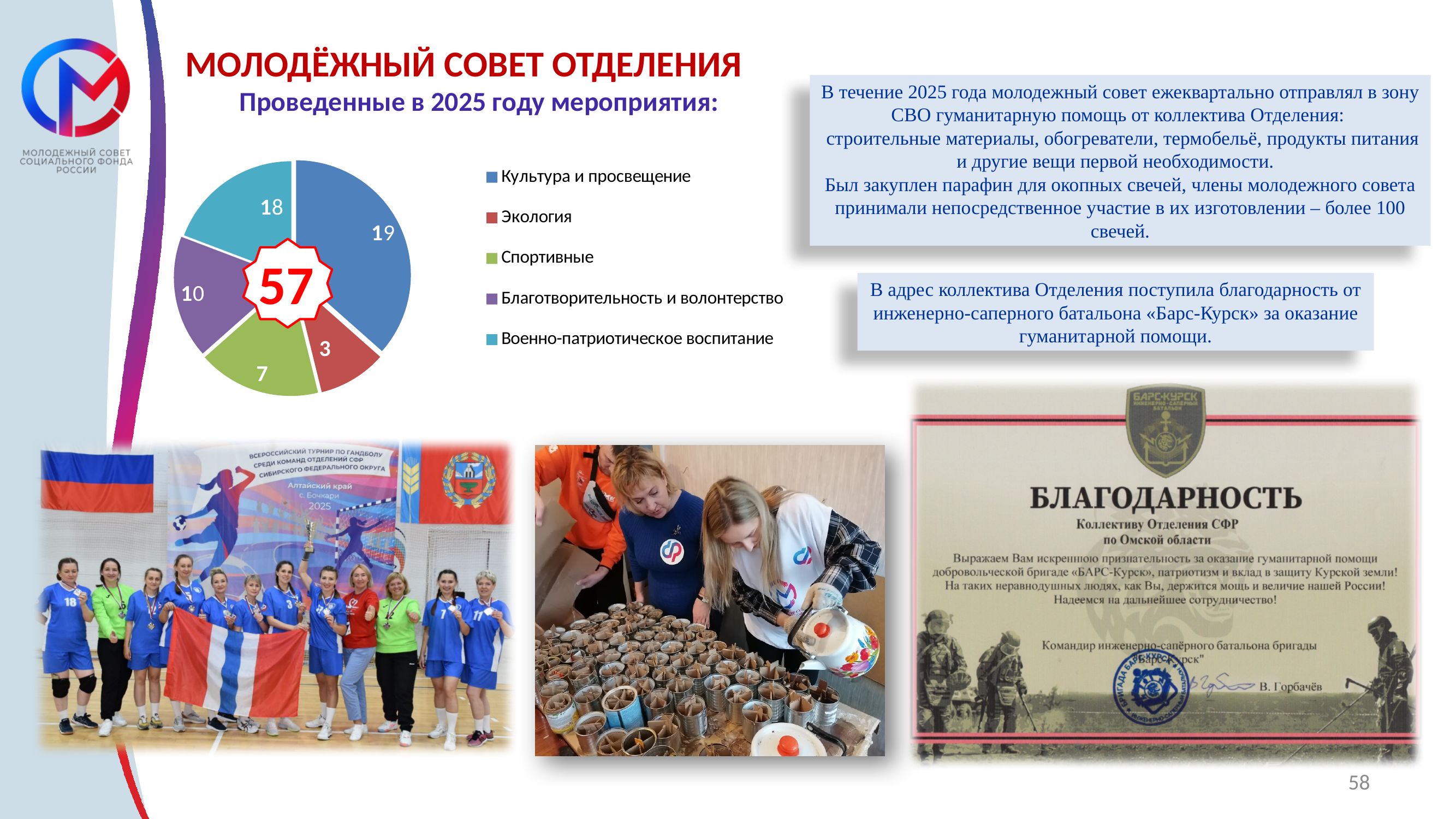
What is the value for Культура и просвещение in the pie chart? 19 What total number is shown in the centre of the pie chart? 57 Which category has the smallest slice in the pie chart? Экология Which is larger in the pie chart: Благотворительность и волонтерство or Спортивные? Благотворительность и волонтерство What is the value for Экология in the pie chart? 3 What is the value for Спортивные in the pie chart? 7 What is the value for Военно-патриотическое воспитание in the pie chart? 18 What is the difference between the values for Культура и просвещение and Военно-патриотическое воспитание? 1 What kind of chart is shown on the slide? pie chart Which category has the largest slice in the pie chart? Культура и просвещение What is the value for Благотворительность и волонтерство in the pie chart? 10 How many slices does the pie chart have? 5